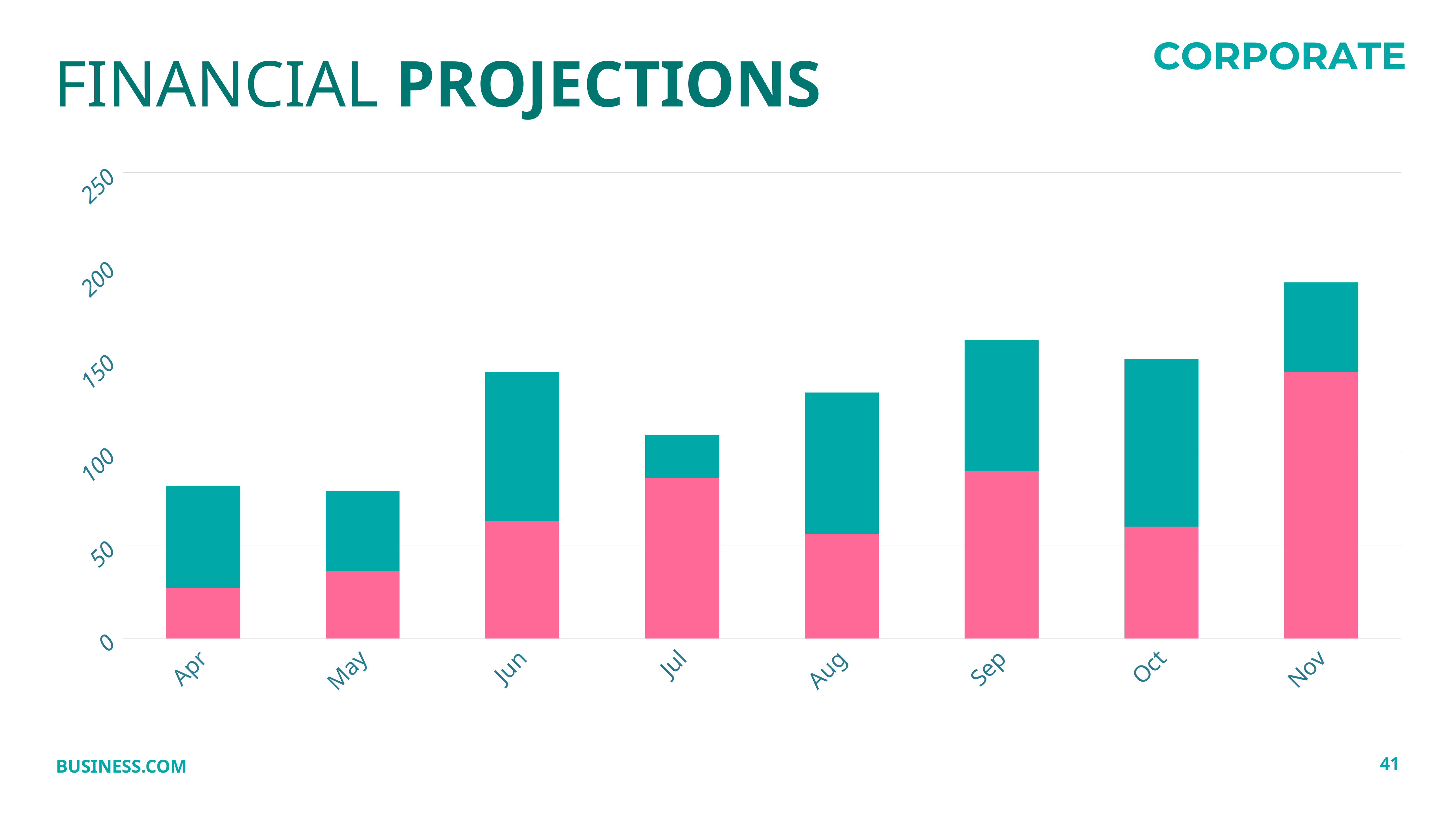
Is the pink segment for Apr greater or less than 50? less Is the pink segment for Nov greater or less than 100? greater What is the title of the slide containing the chart? FINANCIAL PROJECTIONS Is the total bar height for Apr greater or less than 100? less How many series are stacked in each bar of the chart? 2 Which month has the tallest bar in the chart? Nov What kind of chart is shown on the slide? Stacked bar chart Do the total bar heights generally rise or fall from Apr to Nov? rise Which bar is taller in total, Sep or Oct? Sep How many months are shown on the x axis of the chart? 8